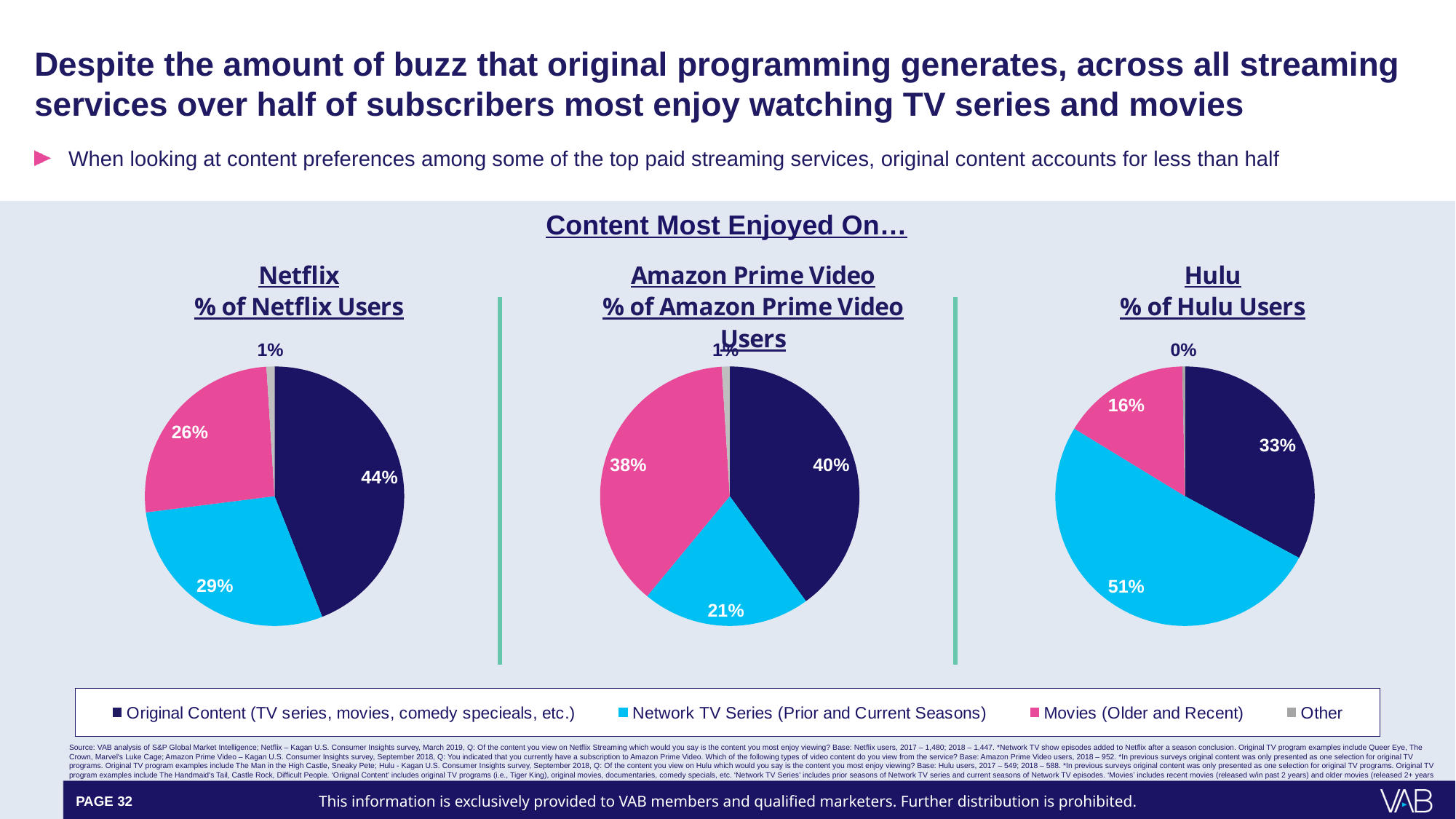
In the Hulu pie chart, what percentage is shown for Other? 0% In the Amazon Prime Video pie chart, what is the difference between the Original Content share and the Network TV Series share? 19 percentage points In the Netflix pie chart, which category has the largest share? Original Content (TV series, movies, comedy specieals, etc.) In the Hulu pie chart, which category has the smallest share? Other How many series does the legend list? 4 In the Amazon Prime Video pie chart, what percentage of users most enjoy Movies (Older and Recent)? 38% In the Netflix pie chart, what percentage of Netflix users most enjoy Original Content? 44% In the Hulu pie chart, what percentage of Hulu users most enjoy Network TV Series (Prior and Current Seasons)? 51% In the Hulu pie chart, what is the difference between the Network TV Series share and the Original Content share? 18 percentage points What type of chart is used for the Netflix, Amazon Prime Video and Hulu data? Pie chart What is the overall title above the three pie charts? Content Most Enjoyed On… In the Netflix pie chart, which is larger: the share for Network TV Series or the share for Movies? Network TV Series (Prior and Current Seasons)